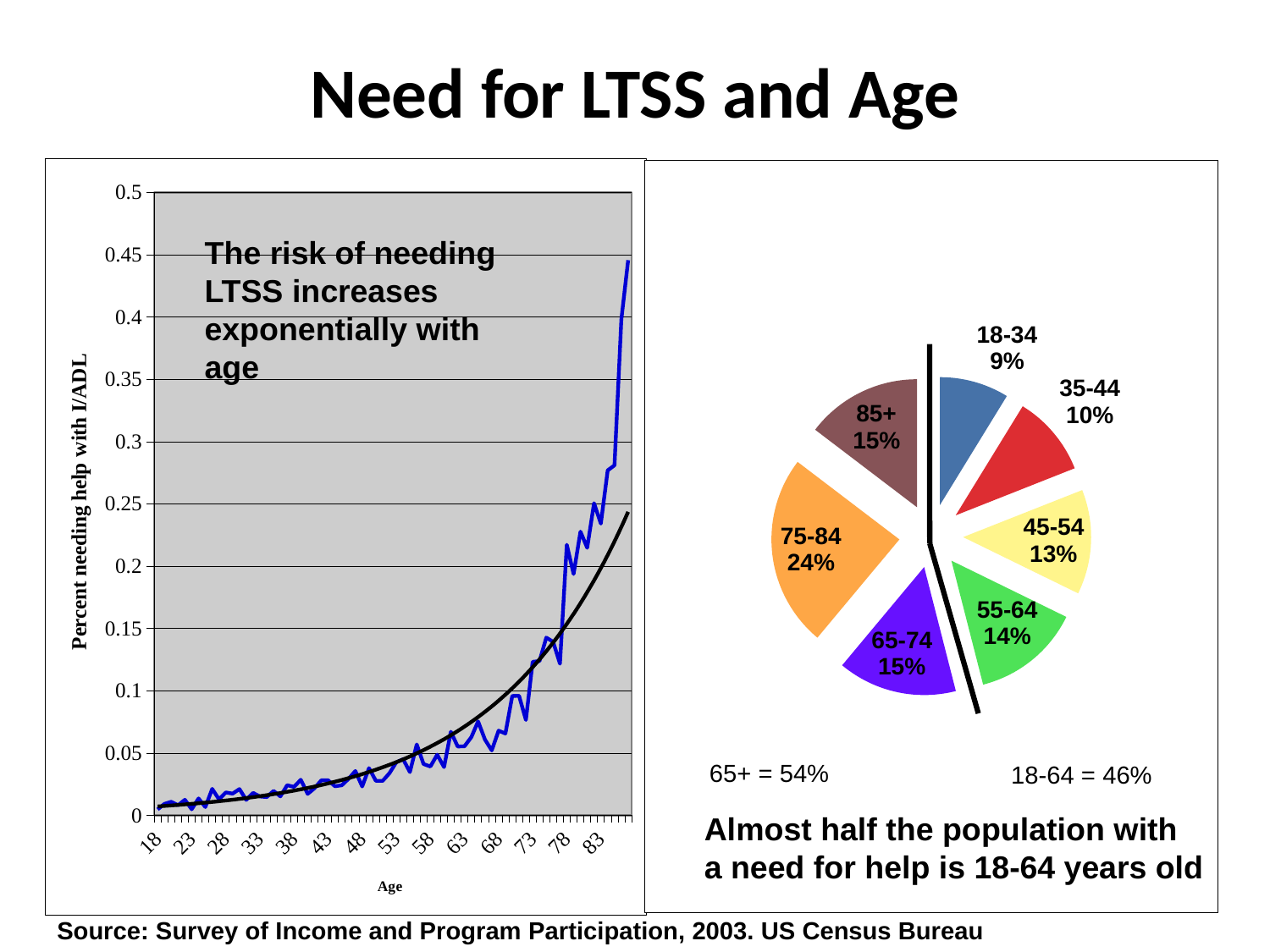
In the pie chart on the right, what percentage is shown for the 18-34 age group? 9% What is the label on the vertical axis of the line chart on the left? Percent needing help with I/ADL In the pie chart on the right, which has the larger share, the 45-54 group or the 55-64 group? 55-64 In the line chart on the left, does the percent needing help with I/ADL rise or fall as age increases? Rises In the pie chart on the right, which age group has the largest share? 75-84 In the pie chart on the right, which age group has the smallest share? 18-34 In the pie chart on the right, what is the difference in percentage points between the 75-84 group and the 18-34 group? 15 percentage points How many age-group slices does the pie chart on the right have? 7 What kind of chart is the chart on the left of the slide? Line chart In the pie chart on the right, what percentage is shown for the 75-84 age group? 24% In the pie chart on the right, what share of the pie does the 85+ group represent? 15% In the line chart on the left, is the value at age 48 greater or less than 0.05? less